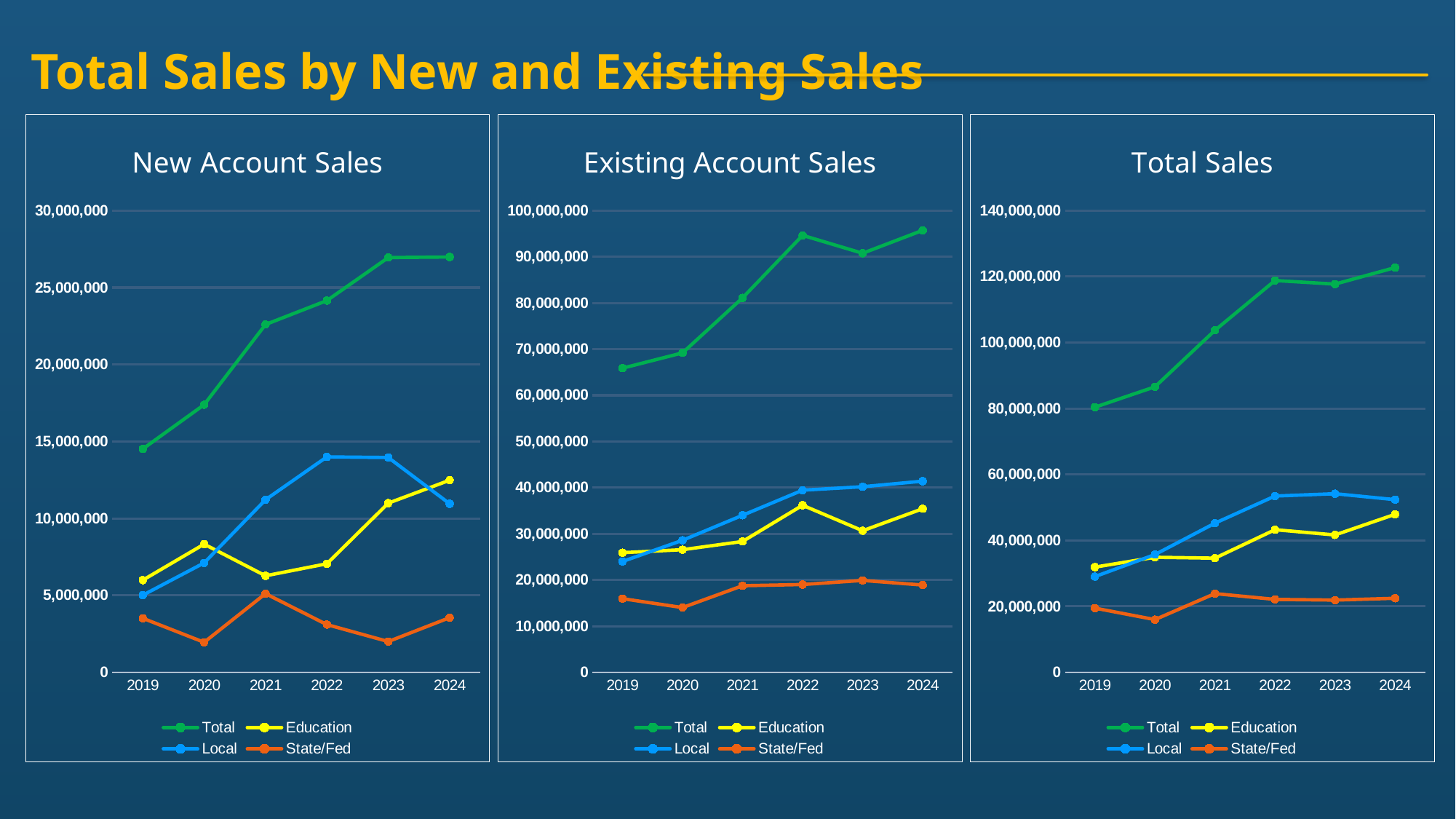
In the Total Sales chart, does the Total series rise or fall from 2019 to 2022? rise How many series does the legend of the Total Sales chart list? 4 In the Total Sales chart, which year has the highest Total value? 2024 In the New Account Sales chart, which is larger in 2022: Local or Education? Local What is the title of the middle chart on the slide? Existing Account Sales In the Existing Account Sales chart, is the Total value for 2022 greater or less than 90,000,000? greater What kind of chart is the New Account Sales chart? line chart In the Total Sales chart, which year has the lowest Total value? 2019 In the Existing Account Sales chart, which year has the lowest State/Fed value? 2020 In the Total Sales chart, is the Local value for 2023 greater or less than 60,000,000? less How many years are plotted on the x axis of the Existing Account Sales chart? 6 In the New Account Sales chart, is the Total value for 2024 greater or less than 25,000,000? greater